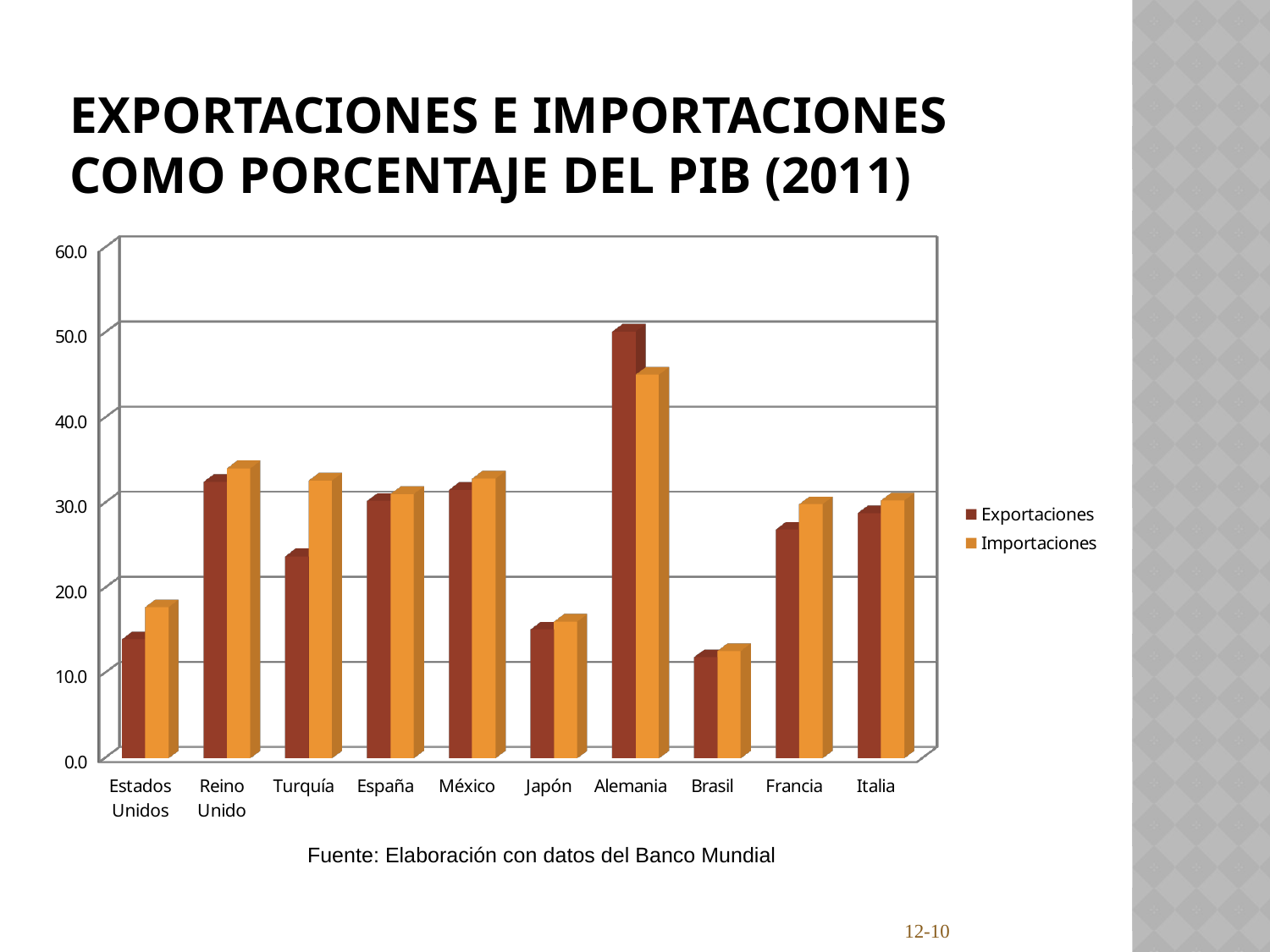
How many series does the chart's legend list? 2 Is the Exportaciones value for Alemania greater or less than 40.0? greater Is the Importaciones value for Estados Unidos greater or less than 20.0? less Which country has the highest Exportaciones value? Alemania Which country has the lowest Exportaciones value? Brasil What is the source cited below the chart? Elaboración con datos del Banco Mundial For Alemania, which is larger: Exportaciones or Importaciones? Exportaciones Which country has the highest Importaciones value? Alemania What kind of chart is shown on the slide? Bar chart Is the Exportaciones value for Turquía greater or less than 20.0? greater How many countries are shown on the x axis of the chart? 10 For Turquía, which is larger: Exportaciones or Importaciones? Importaciones